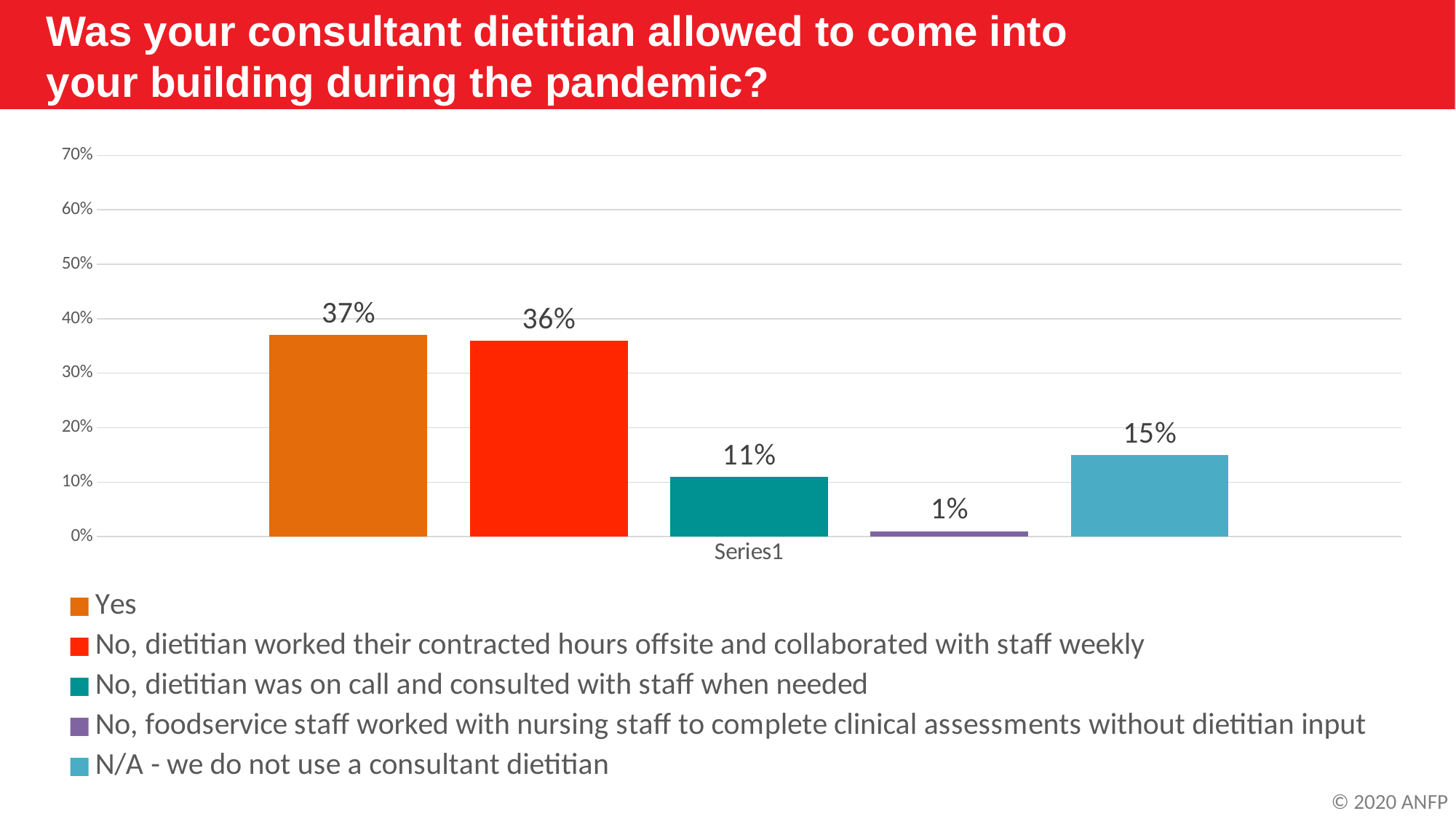
What percentage of respondents answered "Yes"? 37% What percentage answered "No, dietitian worked their contracted hours offsite and collaborated with staff weekly"? 36% What colour is the bar for "Yes"? Orange What is the difference between the "Yes" percentage and the "N/A - we do not use a consultant dietitian" percentage? 22% What percentage answered "No, dietitian was on call and consulted with staff when needed"? 11% Which response option has the lowest percentage? No, foodservice staff worked with nursing staff to complete clinical assessments without dietitian input What kind of chart is shown on the slide? Bar chart Which response option has the highest percentage? Yes What percentage answered "N/A - we do not use a consultant dietitian"? 15% What is the highest value shown on the vertical axis? 70% Which is larger: the percentage for "No, dietitian was on call and consulted with staff when needed" or for "N/A - we do not use a consultant dietitian"? N/A - we do not use a consultant dietitian How many response options are plotted in the chart? 5